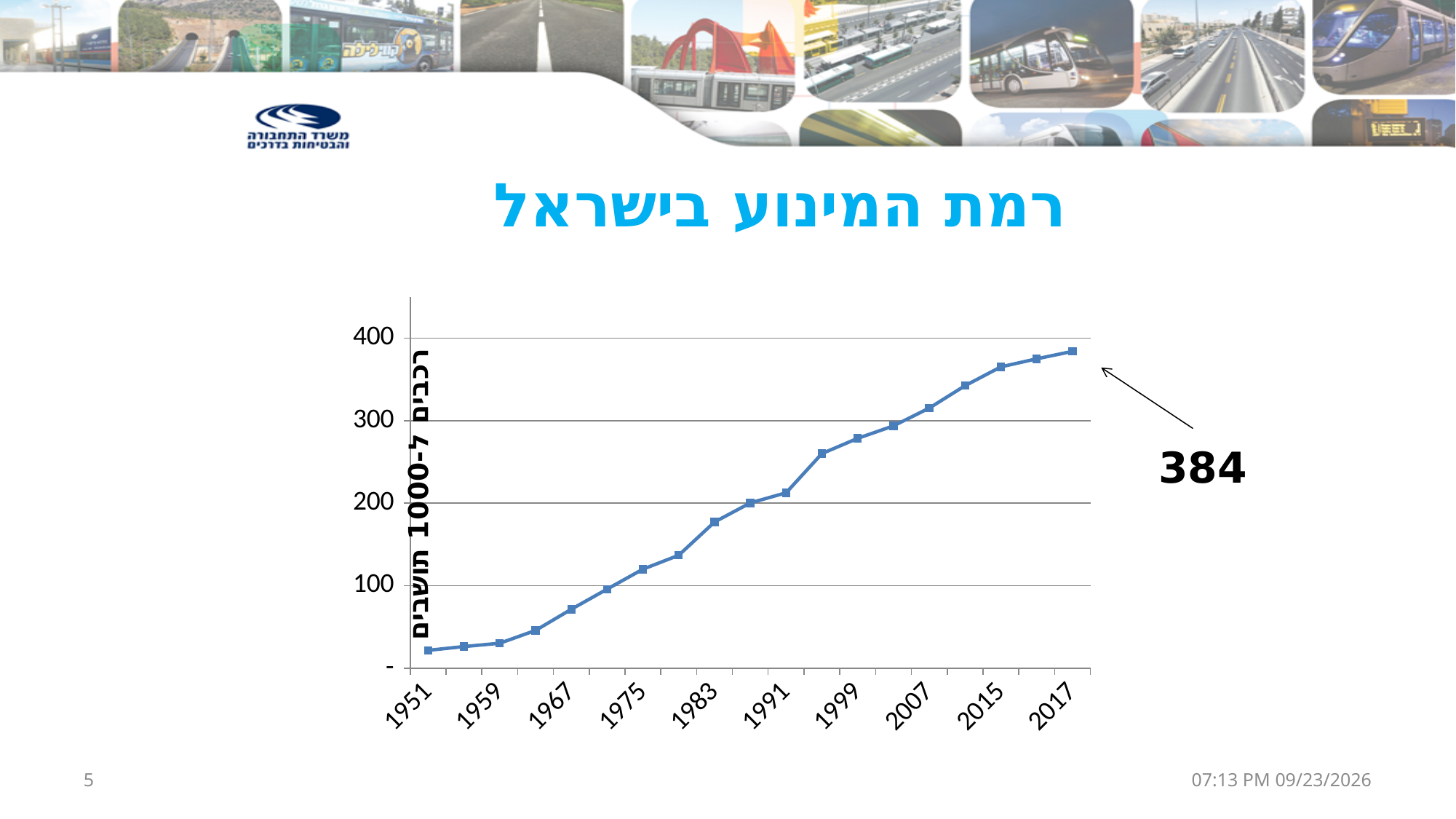
Which year has the lowest value on the chart? 1951 What is the title of the chart on the slide? רמת המינוע בישראל Is the value for 2007 greater or less than 300? greater Is the value for 1983 greater or less than 200? less What is the value annotated for the last point (2017) on the chart? 384 Do the values rise or fall from 1951 to 2017? rise Which is larger, the value for 1999 or the value for 1975? 1999 Is the value for 1951 greater or less than 100? less Which year has the highest value on the chart? 2017 How many year labels are shown on the x axis? 10 What kind of chart is shown on the slide? line chart